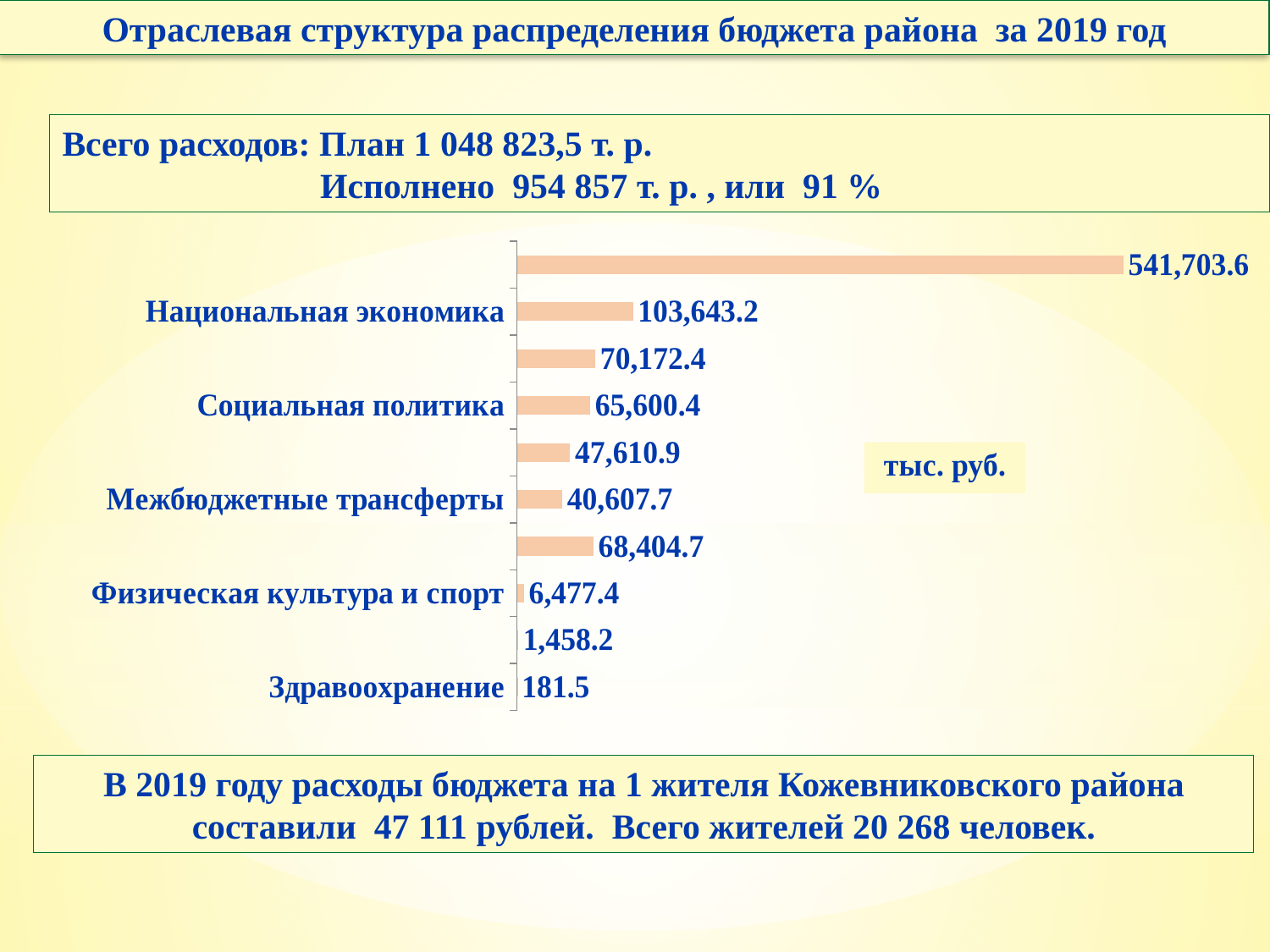
What is the difference between Социальная политика and Межбюджетные трансферты? 24,992.7 What is the value for Межбюджетные трансферты? 40,607.7 What is the value for Национальная экономика? 103,643.2 What is the value for Социальная политика? 65,600.4 What type of chart is shown on the slide? Bar chart Which labelled category has the lowest value? Здравоохранение What unit is indicated for the chart values? тыс. руб. What is the value for Физическая культура и спорт? 6,477.4 What is the value for Здравоохранение? 181.5 What is the largest value shown on the chart? 541,703.6 Which is larger, Национальная экономика or Социальная политика? Национальная экономика How many bars are plotted on the chart? 10